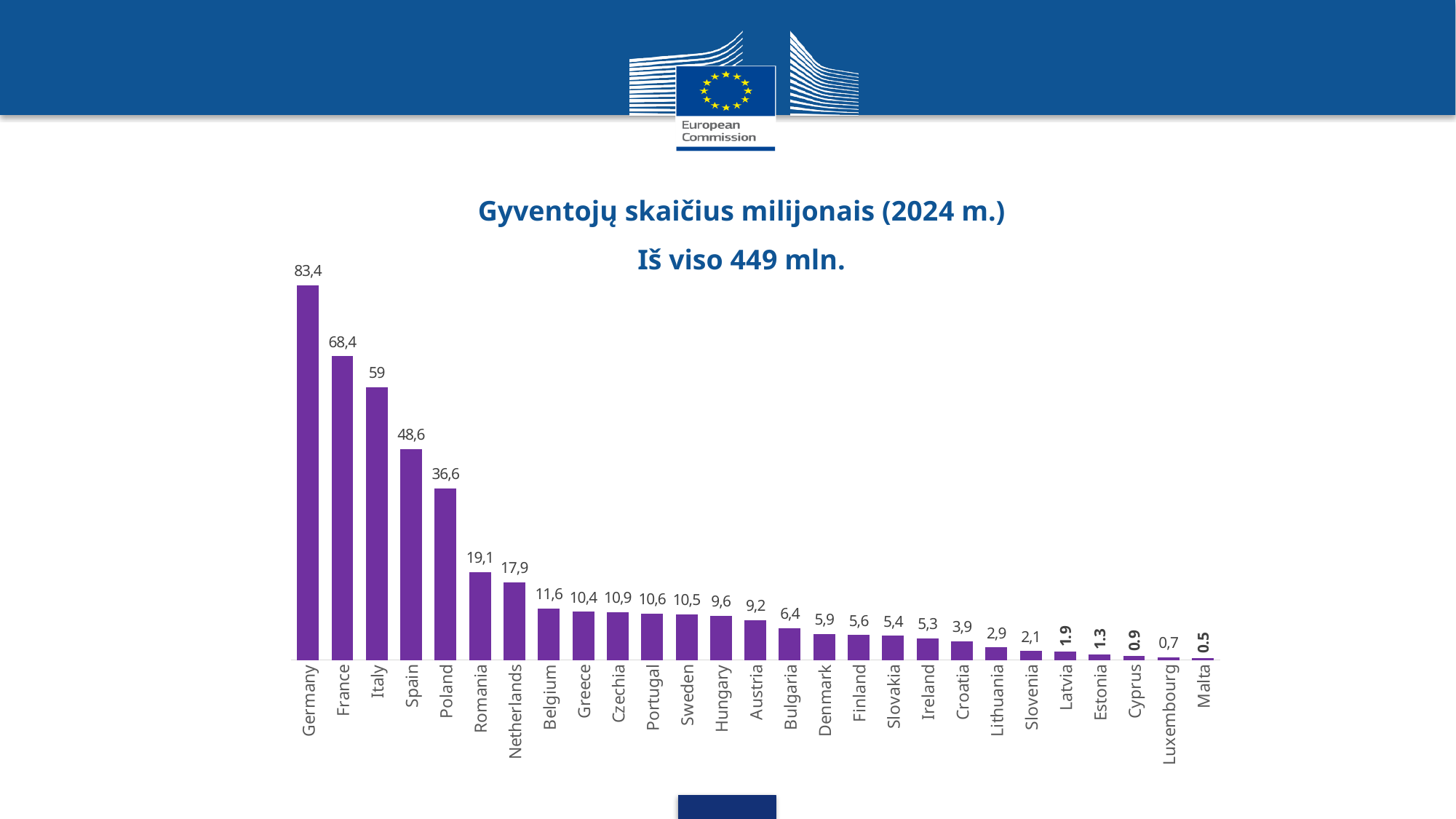
What is the population value shown for Germany? 83,4 Which has a larger value, Netherlands or Belgium? Netherlands Do the values rise or fall from left to right along the x axis? Fall What is the population value shown for Poland? 36,6 What is the difference between the values for Italy and Spain? 10,4 What is the difference between the values for Germany and France? 15 What is the population value shown for Malta? 0.5 Which country has the lowest population in the chart? Malta Which country has the highest population in the chart? Germany What kind of chart is shown on the slide? Bar chart How many countries are shown in the chart? 27 What is the population value shown for Czechia? 10,9